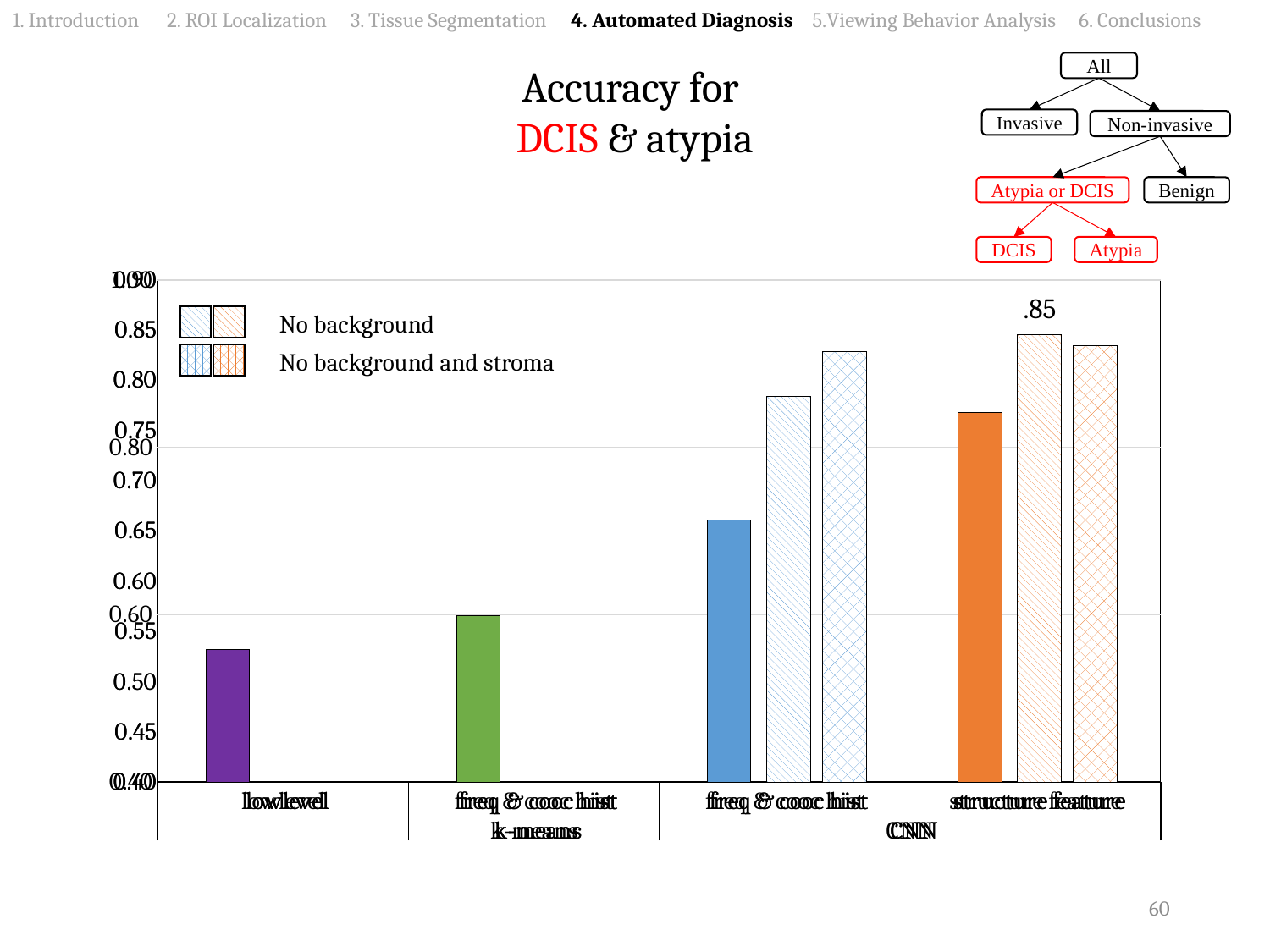
Which is higher, the solid bar for freq & cooc hist under CNN or the solid bar for structure feature? structure feature How many categories are shown along the x axis? 4 How many entries does the legend list? 2 What is the title of the chart? Accuracy for DCIS & atypia Is the value of the labelled structure feature bar greater or less than 0.80? greater Is the value for low level greater or less than 0.60? less Which is higher, the bar for low level or the solid bar for freq & cooc hist under k-means? freq & cooc hist under k-means Which category has the tallest bar in the chart? structure feature What kind of chart is shown on the slide? bar chart Which category has the lowest bar in the chart? lowlevel What value is printed above the tallest bar for structure feature? .85 Do the solid bars rise or fall from left to right along the x axis? rise